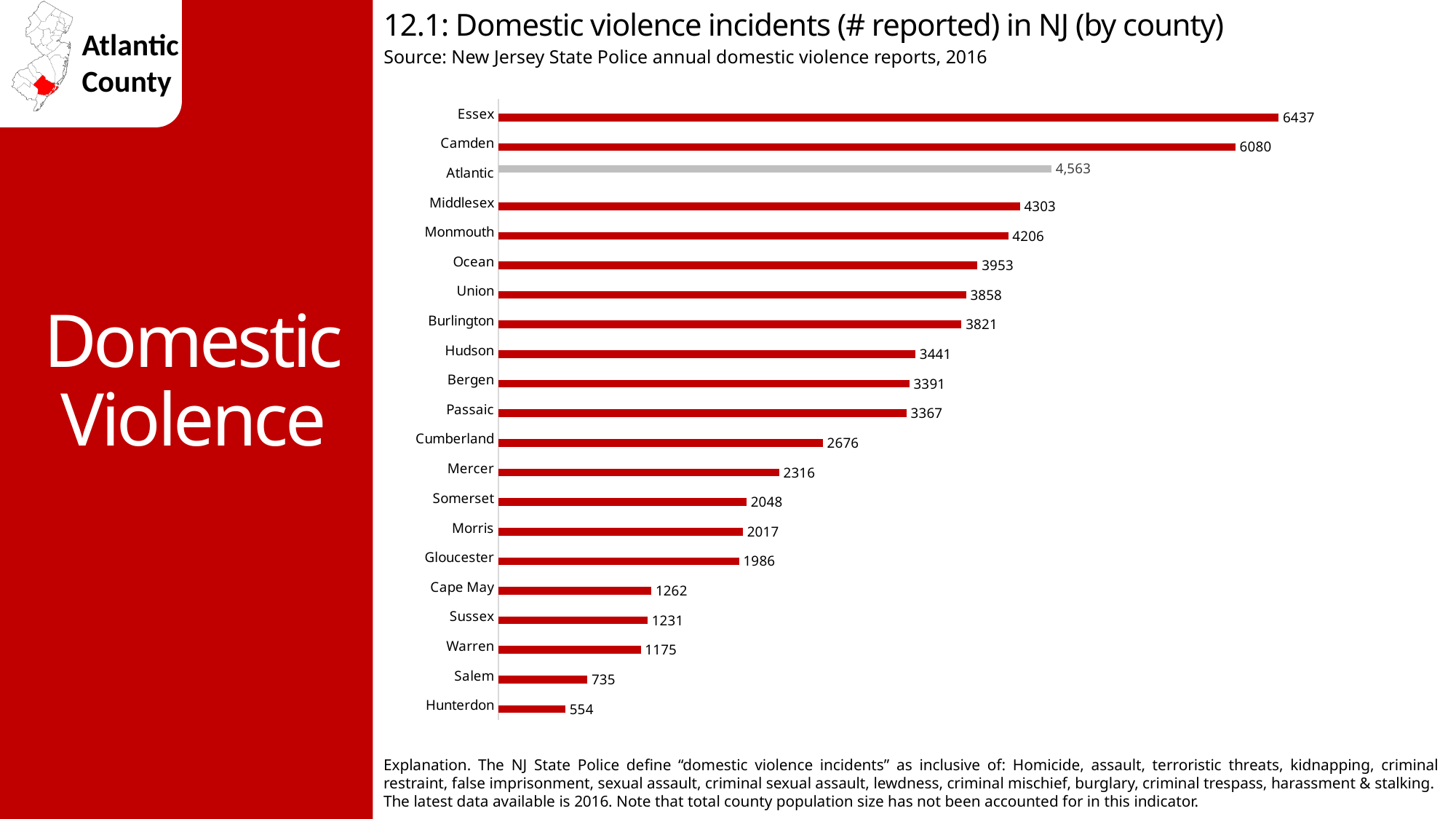
What is the value shown for Cumberland? 2676 Which county has the lowest number of reported domestic violence incidents? Hunterdon What is the difference between the values for Salem and Hunterdon? 181 What type of chart is shown on the slide? Bar chart How many domestic violence incidents were reported in Camden County? 6080 How many counties are shown in the chart? 21 What is the difference between the values for Essex and Camden? 357 How many domestic violence incidents were reported in Atlantic County? 4,563 Which county has the highest number of reported domestic violence incidents? Essex Which county has more reported incidents, Middlesex or Monmouth? Middlesex Which county's bar is coloured grey instead of red? Atlantic Which county has more reported incidents, Cape May or Warren? Cape May